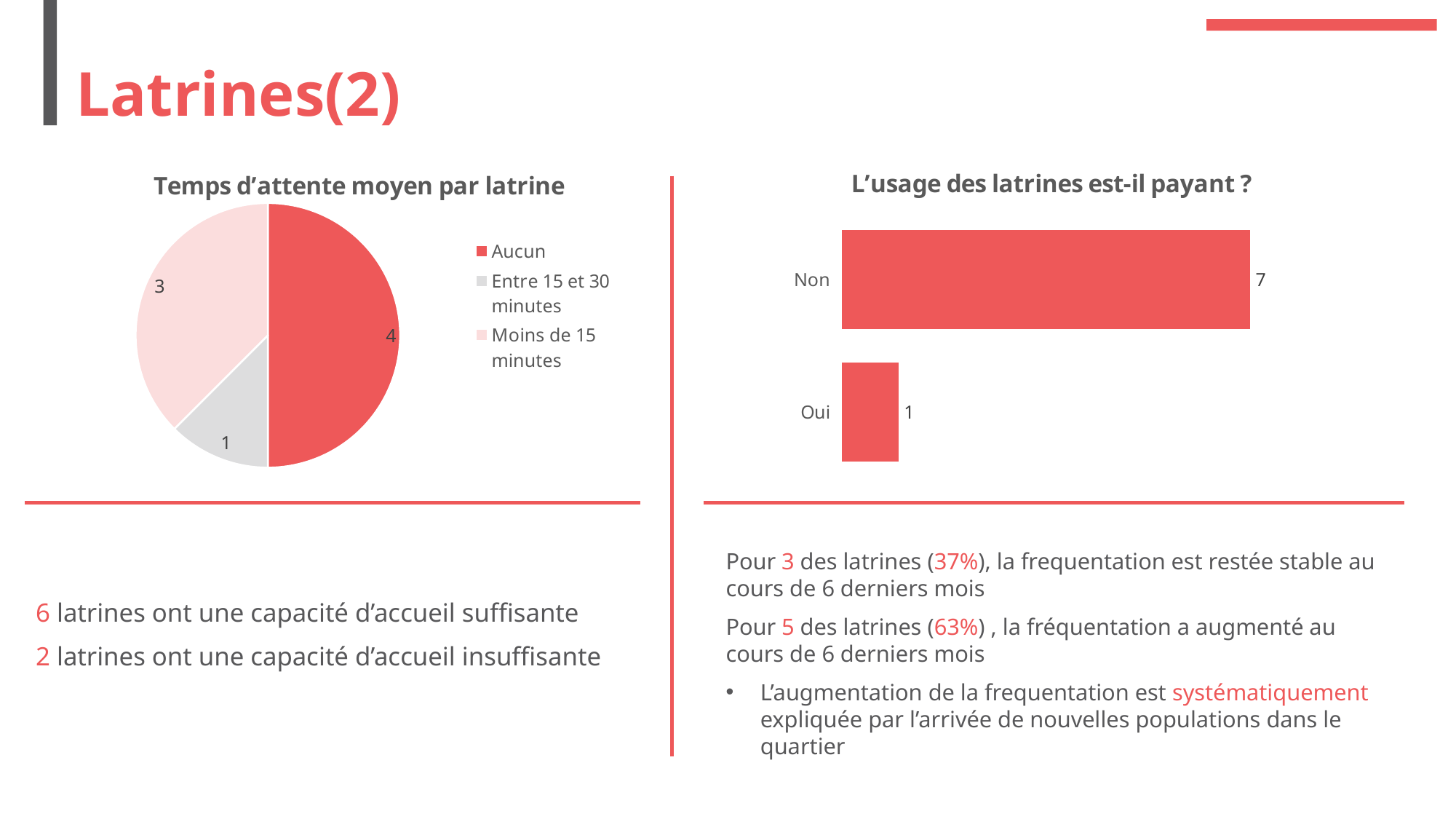
What type of chart is 'Temps d'attente moyen par latrine'? Pie chart In the pie chart 'Temps d'attente moyen par latrine', which category has the largest slice? Aucun In the pie chart 'Temps d'attente moyen par latrine', which category has the smallest slice? Entre 15 et 30 minutes In the pie chart 'Temps d'attente moyen par latrine', how many categories are shown? 3 In the chart 'L'usage des latrines est-il payant ?', what is the difference between 'Non' and 'Oui'? 6 In the pie chart 'Temps d'attente moyen par latrine', what is the difference between 'Aucun' and 'Entre 15 et 30 minutes'? 3 In the chart 'L'usage des latrines est-il payant ?', what is the value for 'Oui'? 1 In the pie chart 'Temps d'attente moyen par latrine', what share of the total does 'Aucun' represent? 50% In the pie chart 'Temps d'attente moyen par latrine', what is the value for 'Aucun'? 4 In the pie chart 'Temps d'attente moyen par latrine', what is the value for 'Moins de 15 minutes'? 3 What type of chart is 'L'usage des latrines est-il payant ?'? Bar chart In the chart 'L'usage des latrines est-il payant ?', what is the value for 'Non'? 7